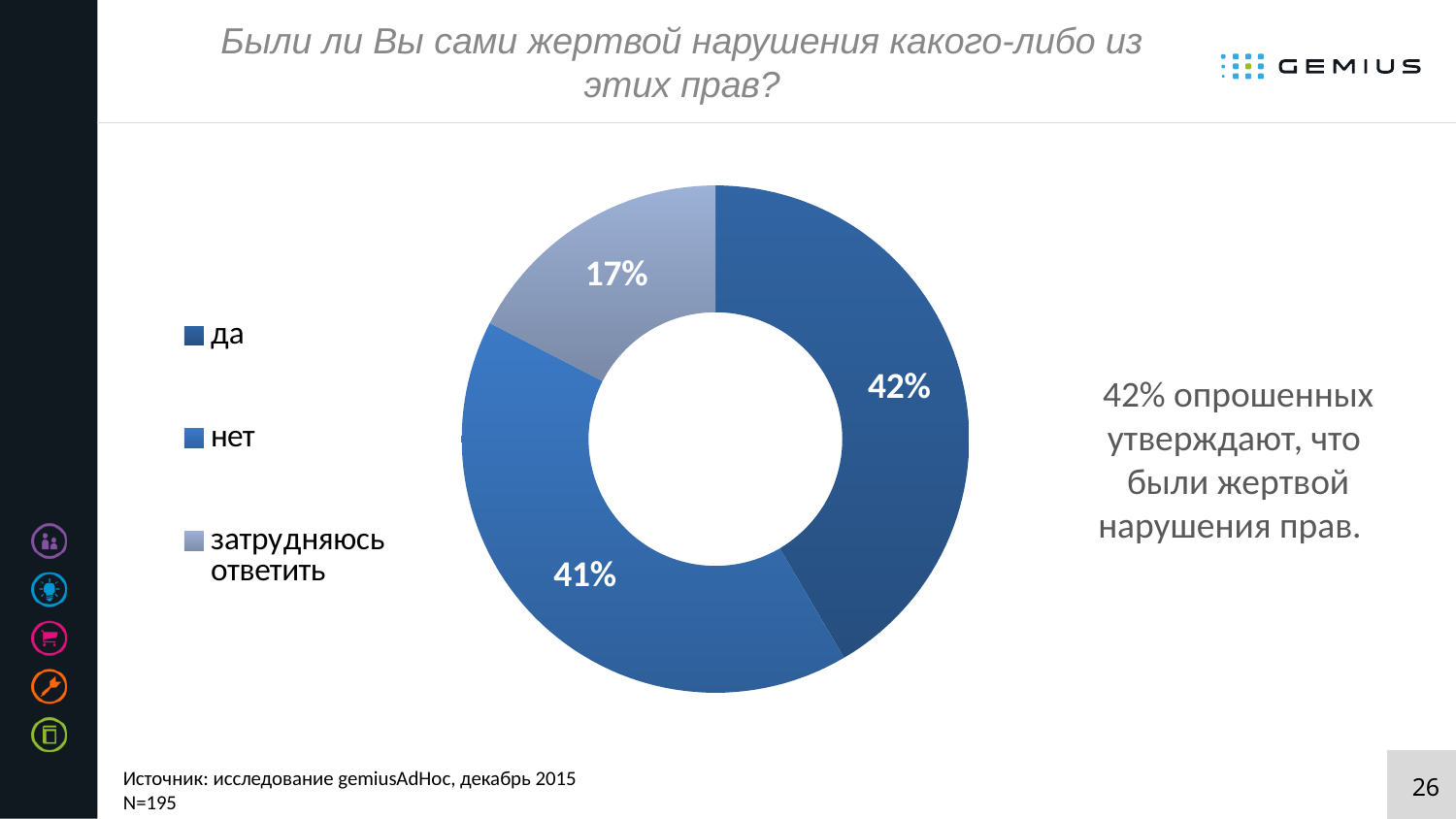
What share of respondents answered "нет"? 41% Which is larger, the share for "да" or the share for "затрудняюсь ответить"? да How many entries does the legend list? 3 How many categories does the chart show? 3 What is the difference in percentage points between "да" and "нет"? 1 percentage point What is the title of the chart on the slide? Были ли Вы сами жертвой нарушения какого-либо из этих прав? What kind of chart is shown on the slide? Pie (donut) chart What share of respondents answered "затрудняюсь ответить"? 17% Which answer has the smallest share of the chart? затрудняюсь ответить What is the difference in percentage points between "нет" and "затрудняюсь ответить"? 24 percentage points What share of respondents answered "да"? 42% Which answer has the largest share of the chart? да